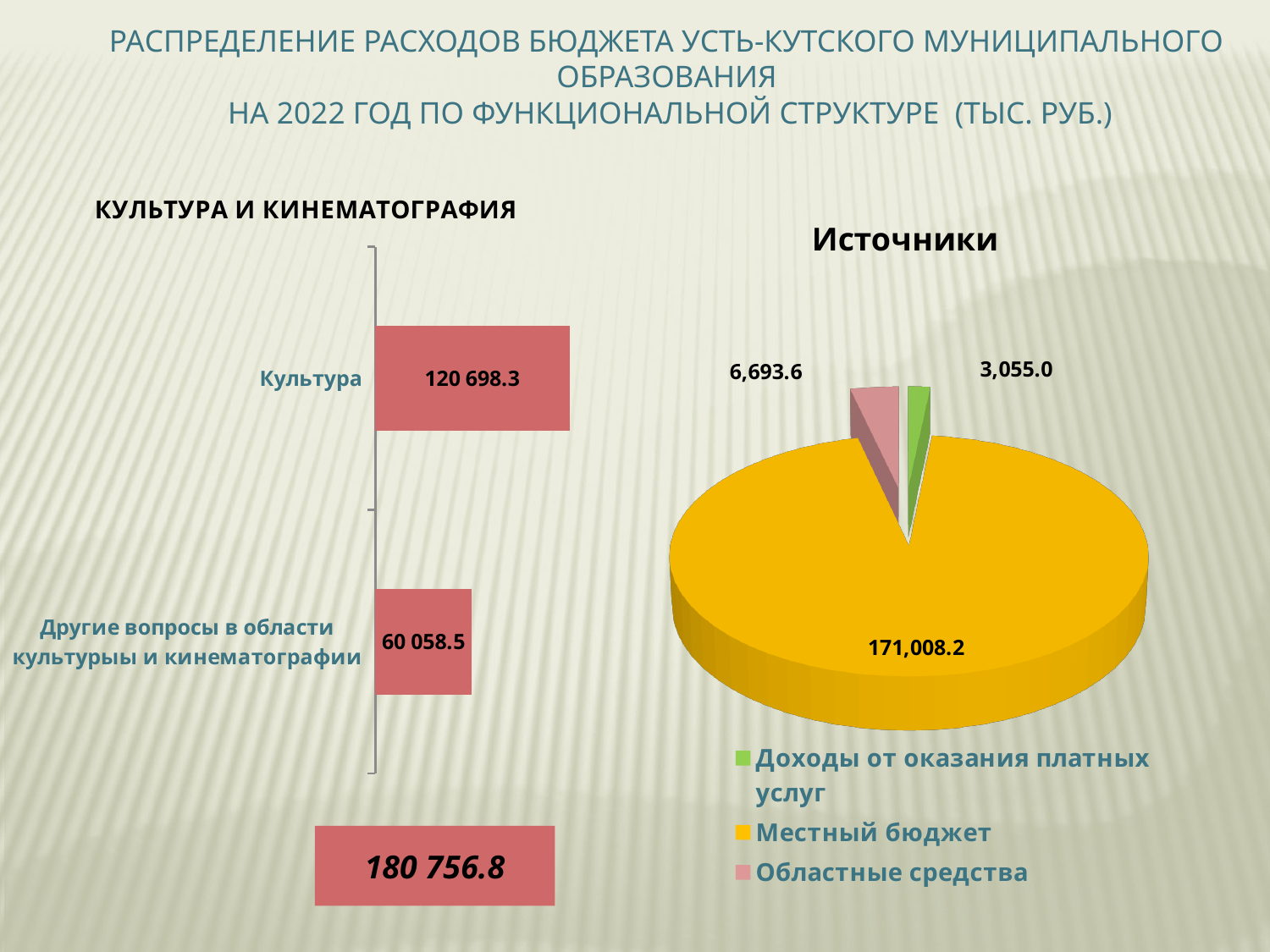
In the bar chart titled 'КУЛЬТУРА И КИНЕМАТОГРАФИЯ', what is the value for 'Культура'? 120 698.3 In the pie chart titled 'Источники', which source has the smallest value? Доходы от оказания платных услуг What kind of chart is the chart titled 'КУЛЬТУРА И КИНЕМАТОГРАФИЯ'? bar chart In the bar chart titled 'КУЛЬТУРА И КИНЕМАТОГРАФИЯ', how many bars are plotted? 2 In the bar chart titled 'КУЛЬТУРА И КИНЕМАТОГРАФИЯ', which category has the highest value? Культура In the pie chart titled 'Источники', what is the value for 'Областные средства'? 6,693.6 In the pie chart titled 'Источники', which is larger: 'Областные средства' or 'Доходы от оказания платных услуг'? Областные средства In the bar chart titled 'КУЛЬТУРА И КИНЕМАТОГРАФИЯ', what is the difference between the value for 'Культура' and the value for 'Другие вопросы в области культурыы и кинематографии'? 60 639.8 In the pie chart titled 'Источники', how many entries does the legend list? 3 In the pie chart titled 'Источники', what is the value for 'Местный бюджет'? 171,008.2 In the bar chart titled 'КУЛЬТУРА И КИНЕМАТОГРАФИЯ', what is the value for 'Другие вопросы в области культурыы и кинематографии'? 60 058.5 In the pie chart titled 'Источники', what colour is the slice for 'Местный бюджет'? yellow